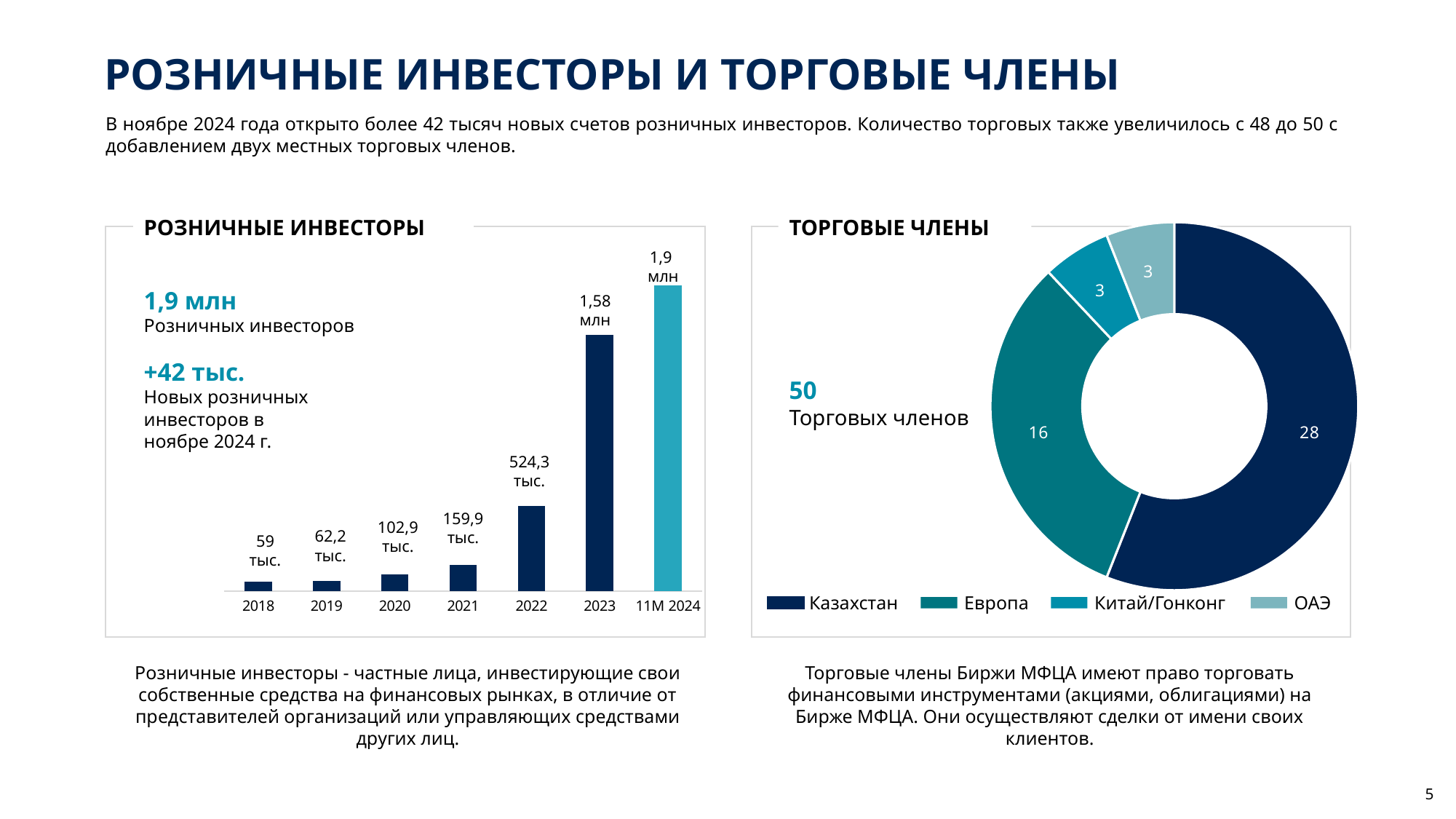
In the 'РОЗНИЧНЫЕ ИНВЕСТОРЫ' chart, which year has the highest value? 11M 2024 In the 'РОЗНИЧНЫЕ ИНВЕСТОРЫ' chart, what is the value for 2018? 59 тыс. In the 'РОЗНИЧНЫЕ ИНВЕСТОРЫ' chart, do the values rise or fall from 2018 to 11M 2024? rise In the 'ТОРГОВЫЕ ЧЛЕНЫ' chart, which category has the largest value? Казахстан In the 'ТОРГОВЫЕ ЧЛЕНЫ' chart, what is the value for Европа? 16 How many categories does the legend of the 'ТОРГОВЫЕ ЧЛЕНЫ' chart list? 4 What kind of chart is the 'РОЗНИЧНЫЕ ИНВЕСТОРЫ' chart? bar chart In the 'РОЗНИЧНЫЕ ИНВЕСТОРЫ' chart, what is the value for 2022? 524,3 тыс. In the 'ТОРГОВЫЕ ЧЛЕНЫ' chart, what is the difference between Казахстан and Европа? 12 In the 'РОЗНИЧНЫЕ ИНВЕСТОРЫ' chart, what is the value for 2023? 1,58 млн In the 'РОЗНИЧНЫЕ ИНВЕСТОРЫ' chart, which year has the lowest value? 2018 In the 'РОЗНИЧНЫЕ ИНВЕСТОРЫ' chart, how many bars are plotted? 7